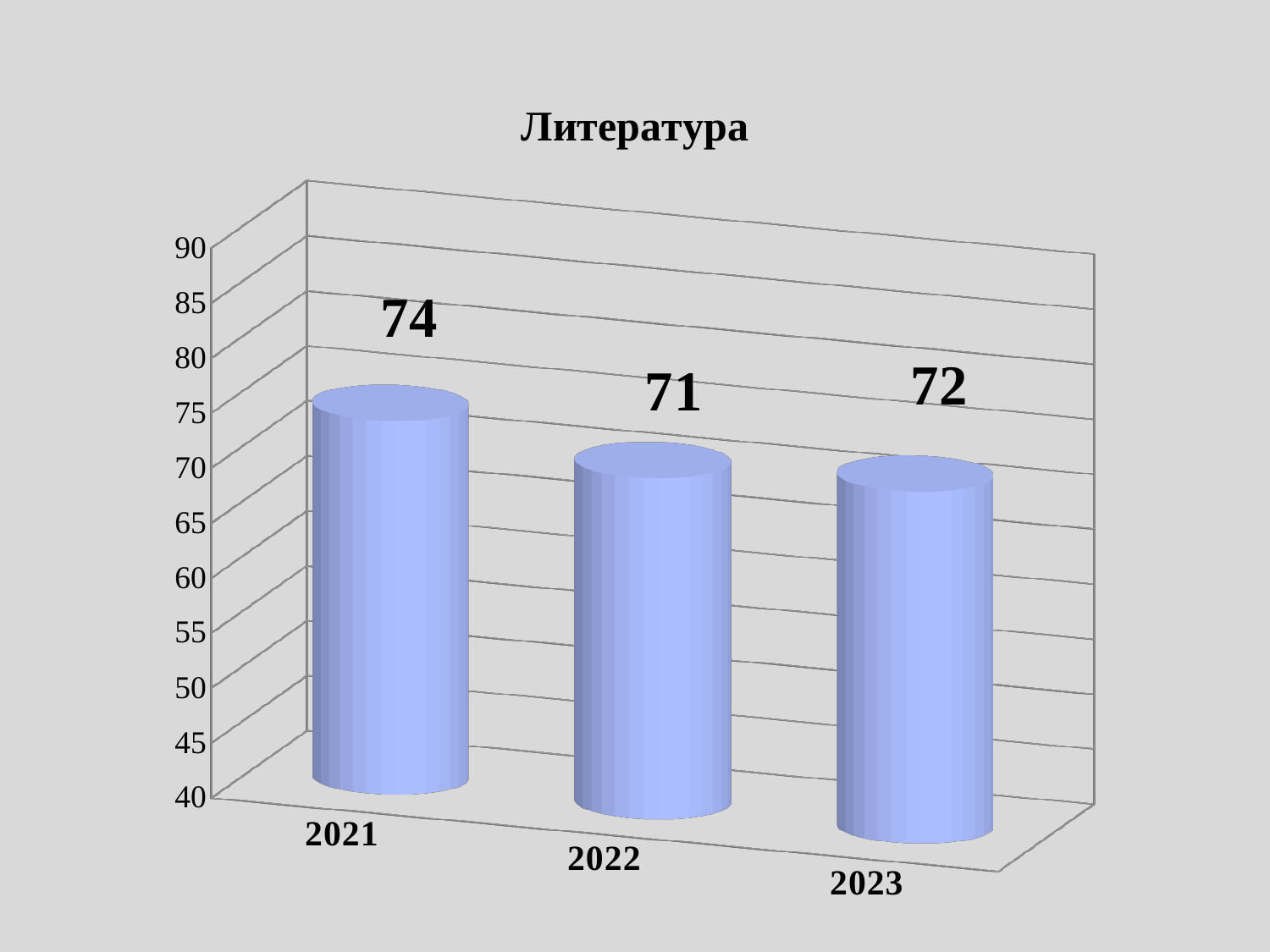
What is the title of the chart? Литература Which year has the lowest value? 2022 What kind of chart is shown? bar chart Is the value for 2022 greater or less than 80? less What is the value for 2021? 74 What is the difference between the values for 2023 and 2022? 1 What is the difference between the values for 2021 and 2022? 3 Which year has the highest value? 2021 Which is larger, the value for 2021 or the value for 2023? 2021 How many years are shown on the chart? 3 What is the value for 2022? 71 What is the value for 2023? 72